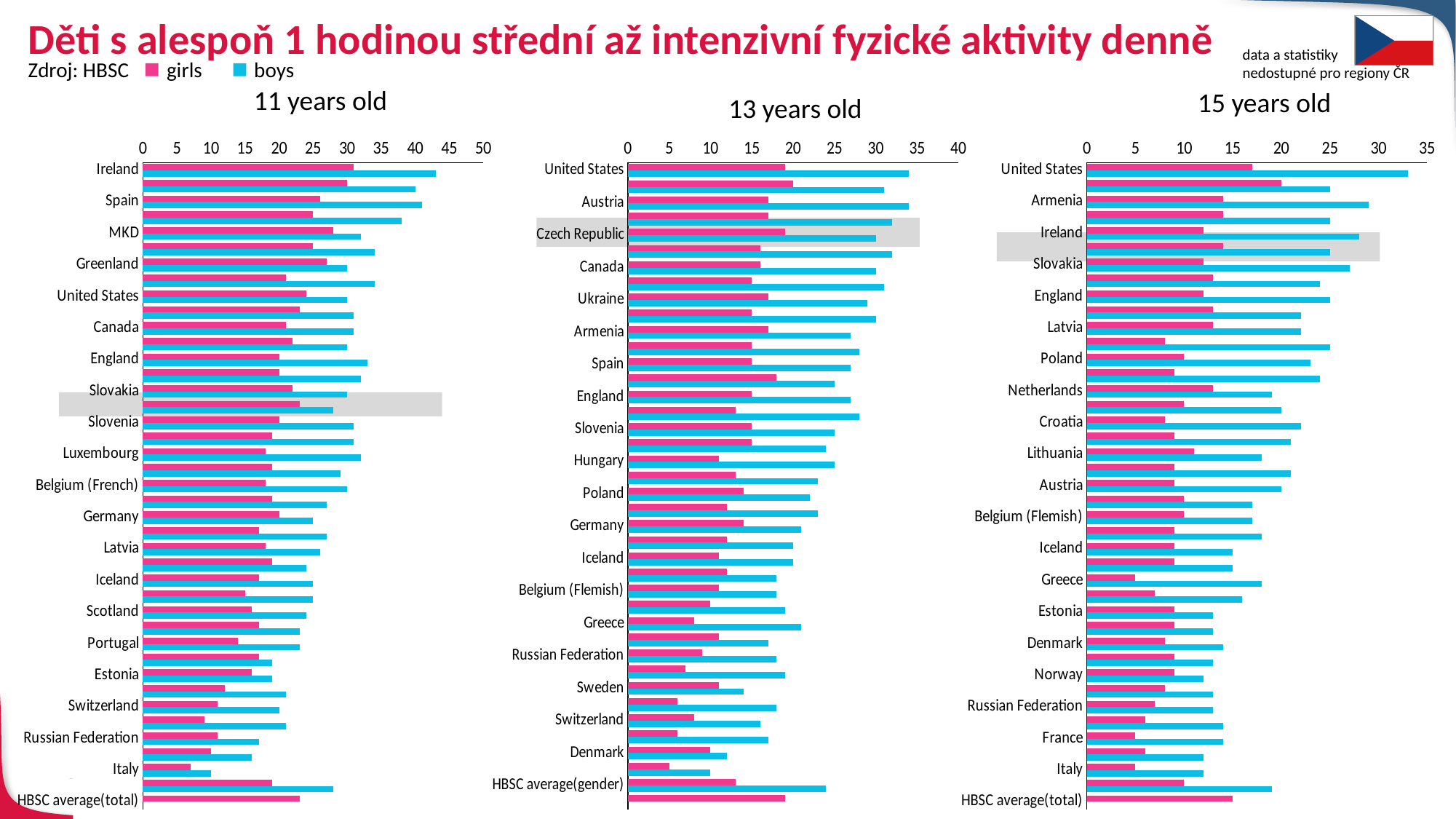
How many series does the legend list? 2 In the '11 years old' chart, which is larger for Ireland, the girls value or the boys value? boys In the '13 years old' chart, which is larger for Hungary, the girls value or the boys value? boys In the '13 years old' chart, is the boys value for United States greater or less than 30? greater What kind of chart is the '11 years old' chart? bar chart Which colour represents girls in the legend? pink What is the title of the middle chart? 13 years old In the '11 years old' chart, is the boys value for Ireland greater or less than 40? greater In the '11 years old' chart, is the boys value for Italy greater or less than 15? less In the '15 years old' chart, which is larger for Greece, the girls value or the boys value? boys